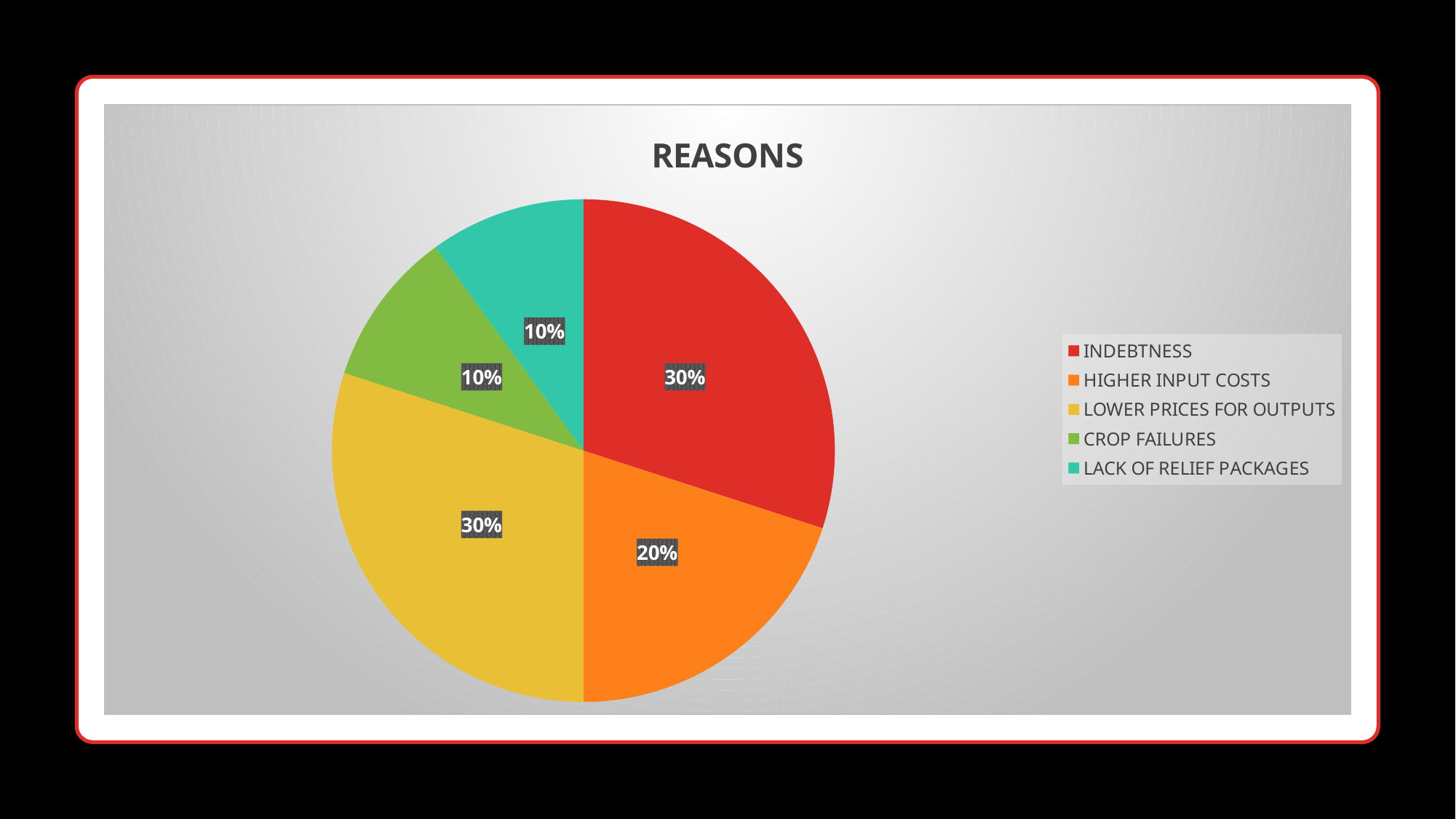
What share of the pie does HIGHER INPUT COSTS represent? 20% What is the title of the chart? REASONS What share of the pie does LOWER PRICES FOR OUTPUTS represent? 30% What share of the pie does CROP FAILURES represent? 10% What share of the pie does LACK OF RELIEF PACKAGES represent? 10% What share of the pie does INDEBTNESS represent? 30% What colour is the slice for LACK OF RELIEF PACKAGES? teal What is the difference between the share for INDEBTNESS and the share for HIGHER INPUT COSTS? 10% How many categories does the pie chart have? 5 What is the difference between the share for LOWER PRICES FOR OUTPUTS and the share for LACK OF RELIEF PACKAGES? 20% What kind of chart is shown on the slide? pie chart Which is larger, the share for HIGHER INPUT COSTS or the share for CROP FAILURES? HIGHER INPUT COSTS